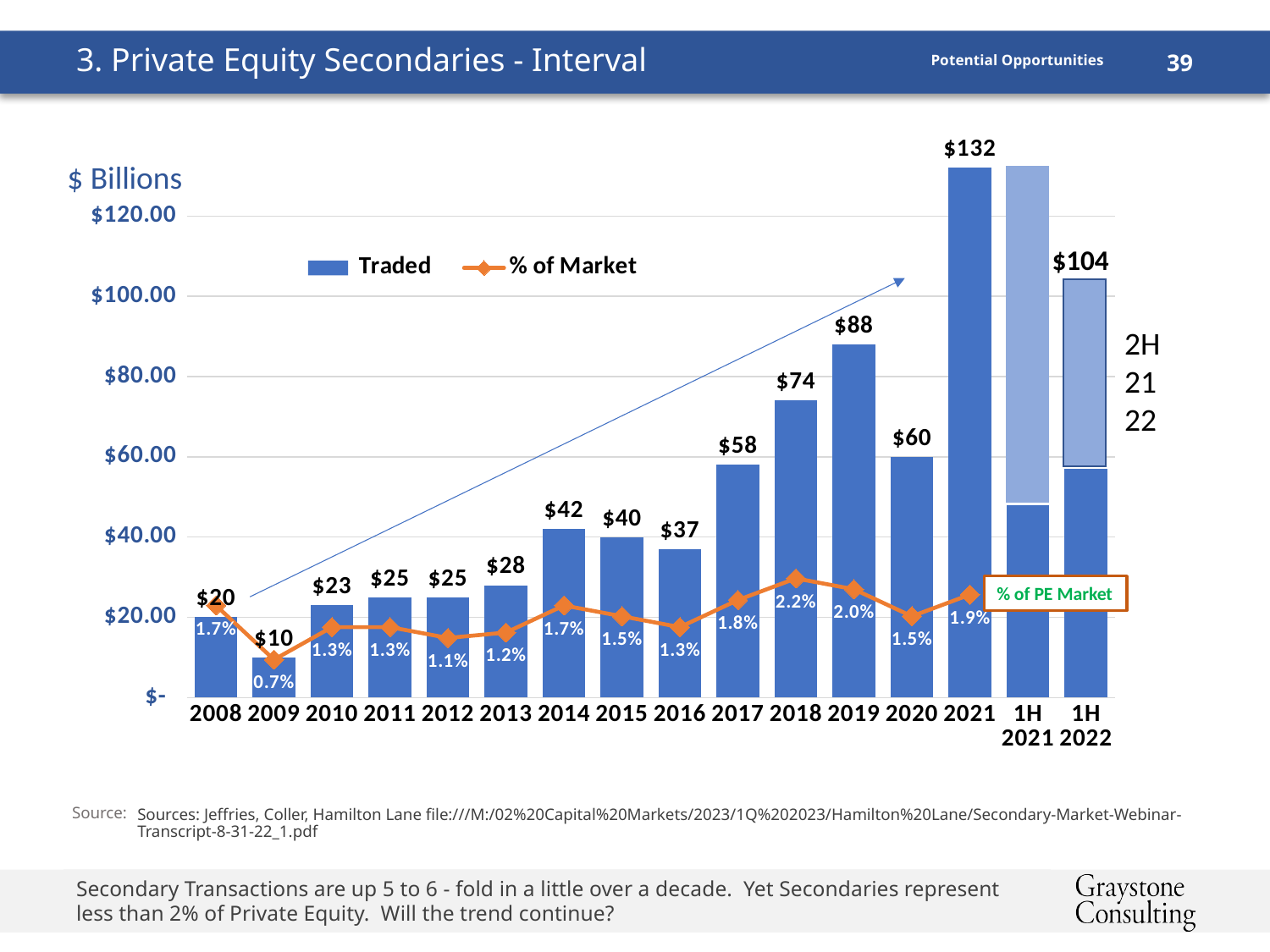
How many series does the legend list? 2 Is the Traded value for 1H 2021 greater or less than $60.00? less How many categories are shown on the x axis? 16 What is the % of Market value for 2018? 2.2% What is the difference between the Traded values for 2021 and 2020? $72 Which year has the highest Traded value? 2021 What kind of chart is used to show the Traded values? Bar chart Which is larger, the Traded value for 2014 or for 2016? 2014 Which year has the lowest Traded value? 2009 What is the Traded value for 2019? $88 Do the Traded values generally rise or fall from 2009 to 2019? Rise